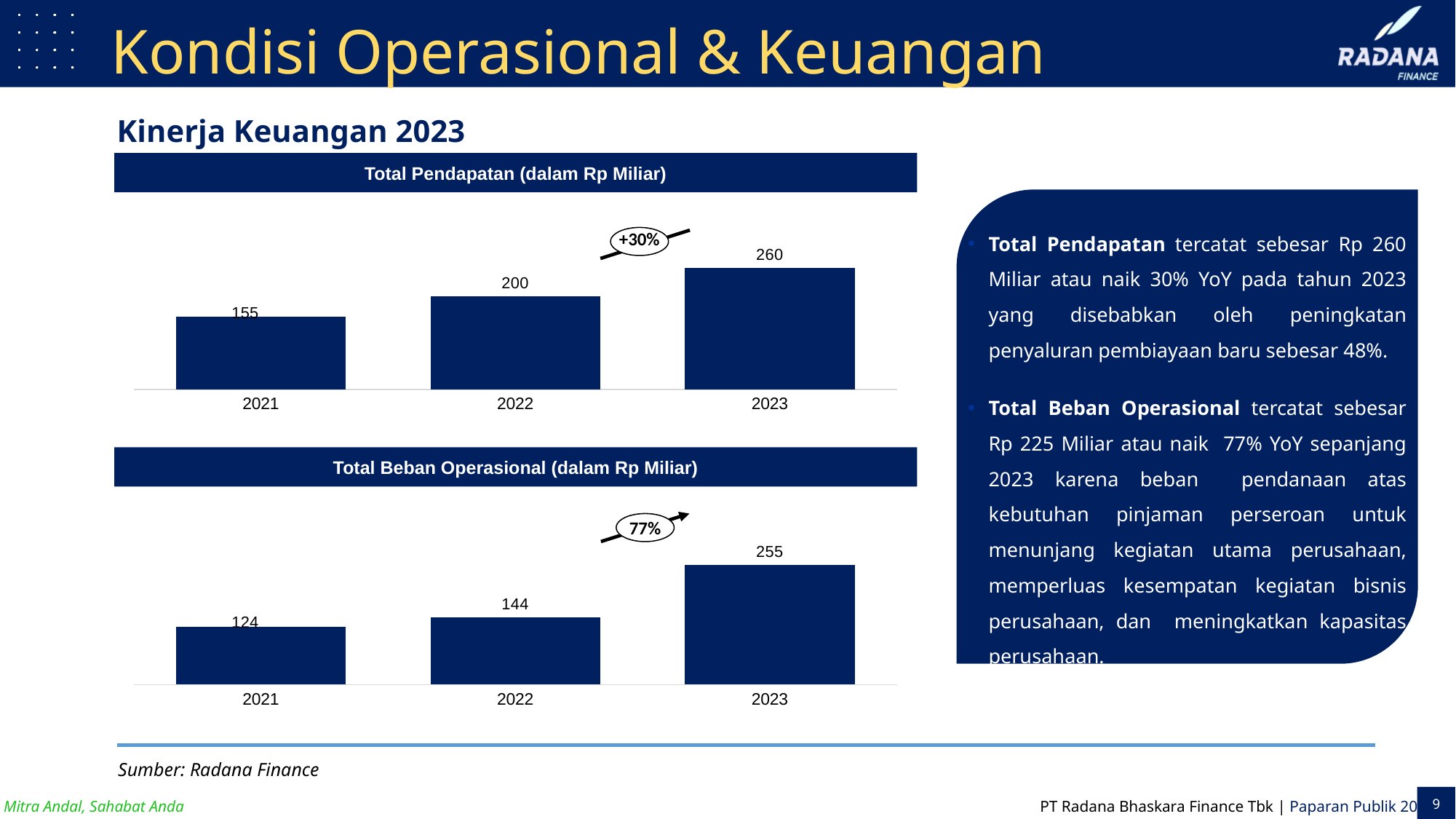
In the Total Pendapatan (dalam Rp Miliar) chart, which year has the highest value? 2023 In the Total Pendapatan (dalam Rp Miliar) chart, which is larger, the value for 2021 or the value for 2022? 2022 In the Total Beban Operasional (dalam Rp Miliar) chart, do the values rise or fall from 2021 to 2023? Rise In the Total Pendapatan (dalam Rp Miliar) chart, what is the difference between the 2023 and 2022 values? 60 In the Total Pendapatan (dalam Rp Miliar) chart, what is the value for 2021? 155 What type of chart is the Total Pendapatan (dalam Rp Miliar) chart? Bar chart In the Total Pendapatan (dalam Rp Miliar) chart, what is the value for 2023? 260 In the Total Beban Operasional (dalam Rp Miliar) chart, what is the value for 2023? 255 In the Total Beban Operasional (dalam Rp Miliar) chart, what is the value for 2022? 144 In the Total Beban Operasional (dalam Rp Miliar) chart, which year has the lowest value? 2021 How many years are shown in the Total Beban Operasional (dalam Rp Miliar) chart? 3 In the Total Beban Operasional (dalam Rp Miliar) chart, what is the difference between the 2023 and 2021 values? 131